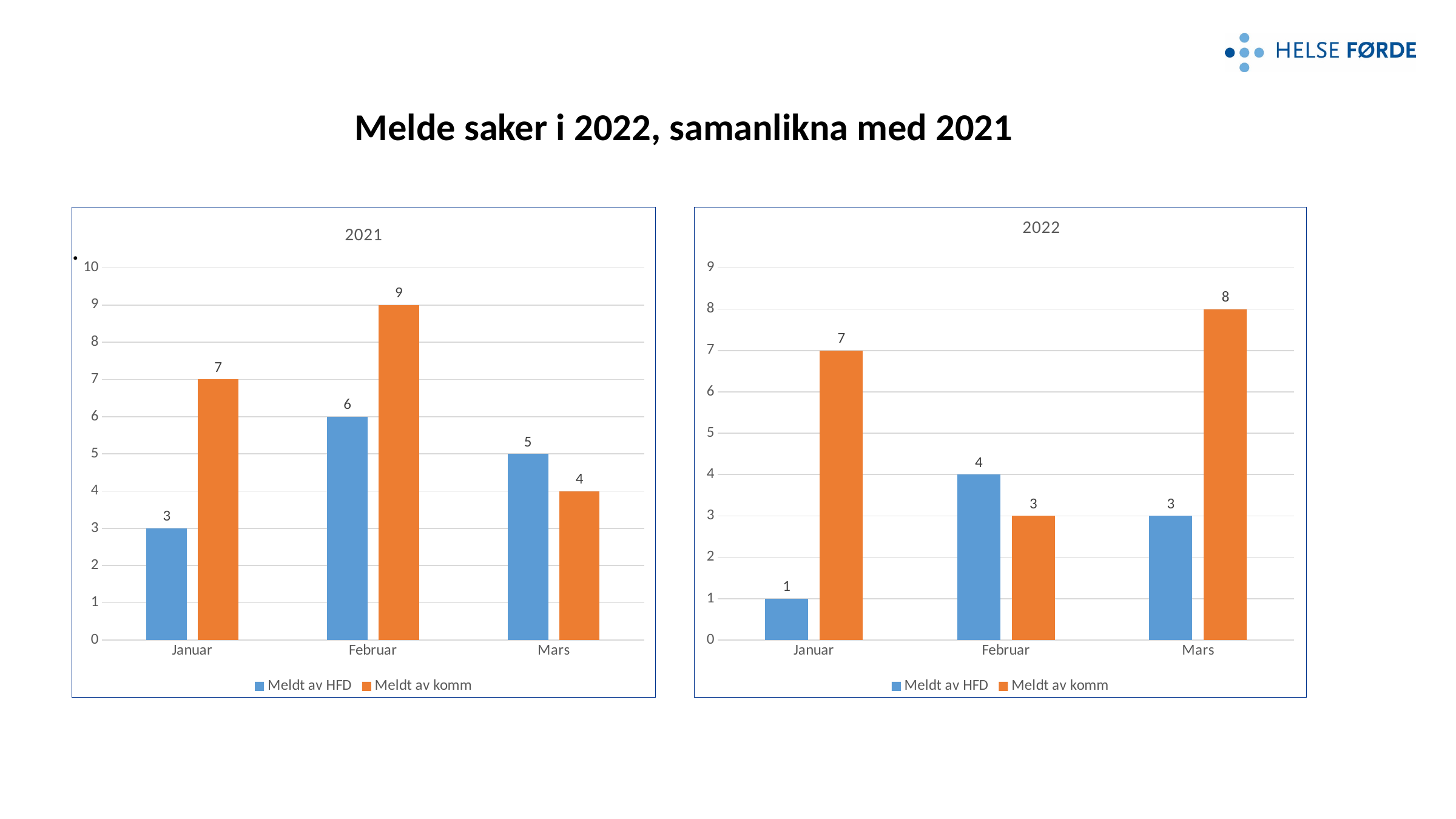
What kind of chart is the 2022 chart? Bar chart In the 2022 chart, is the value for Meldt av komm in Januar greater or less than 5? greater In the 2021 chart, which month has the highest value for Meldt av HFD? Februar In the 2022 chart, which month has the lowest value for Meldt av komm? Februar How many series does the legend of the 2022 chart list? 2 In the 2022 chart, what is the difference between Meldt av komm and Meldt av HFD in Mars? 5 In the 2022 chart, what is the value for Meldt av HFD in Januar? 1 How many months are shown on the x axis of the 2021 chart? 3 What is the title of the slide? Melde saker i 2022, samanlikna med 2021 In the 2021 chart, does the value for Meldt av HFD rise or fall from Januar to Februar? Rise In the 2021 chart, which is larger in Mars: Meldt av HFD or Meldt av komm? Meldt av HFD In the 2021 chart, what is the value for Meldt av komm in Februar? 9